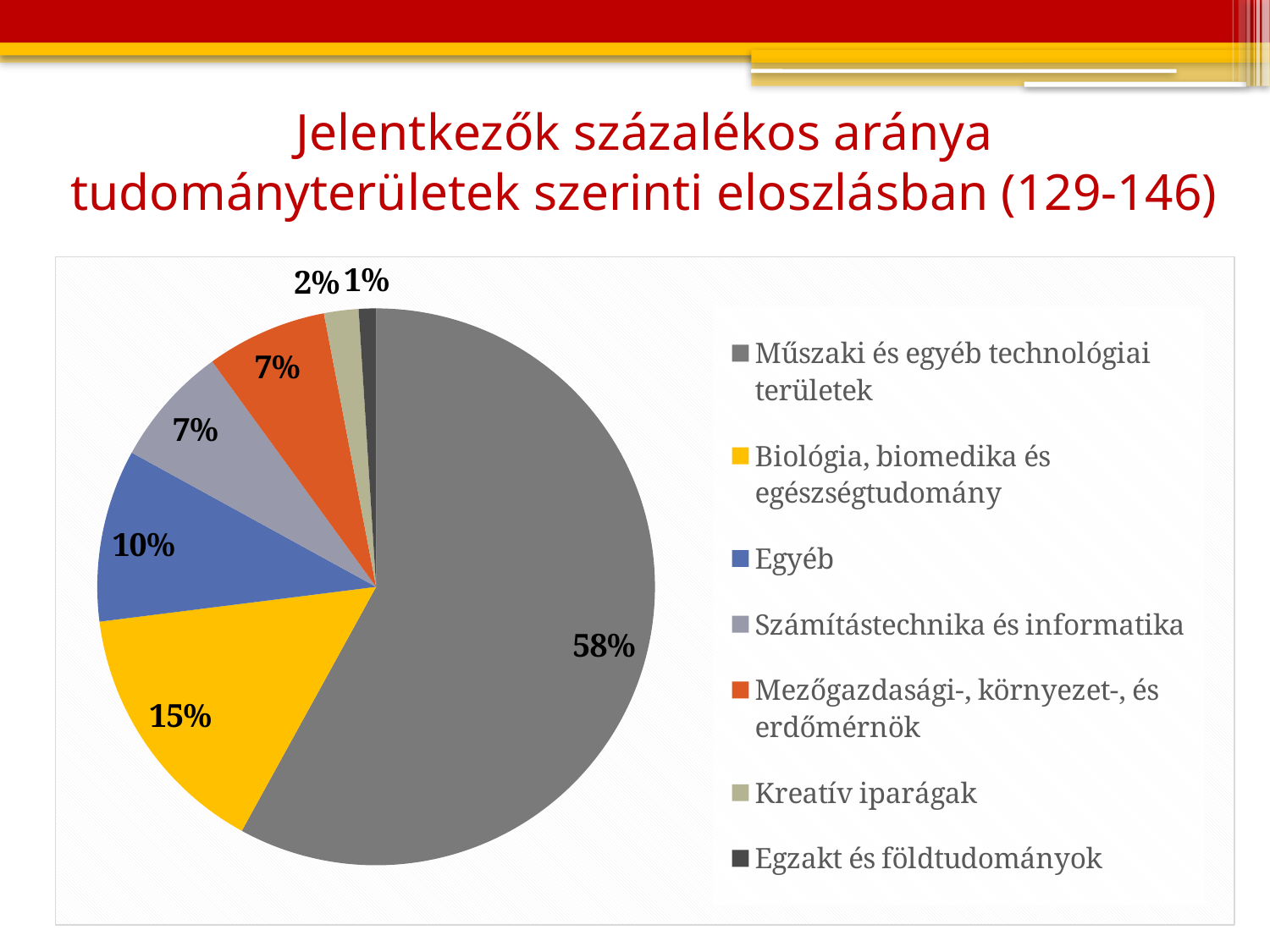
What is the value shown for 'Egyéb'? 10% What kind of chart is shown on the slide? pie chart What share of the pie does 'Műszaki és egyéb technológiai területek' have? 58% What share of the pie does 'Biológia, biomedika és egészségtudomány' have? 15% What is the value shown for 'Egzakt és földtudományok'? 1% What is the value shown for 'Kreatív iparágak'? 2% What is the difference between the shares of 'Műszaki és egyéb technológiai területek' and 'Biológia, biomedika és egészségtudomány'? 43% Which is larger, the share of 'Egyéb' or the share of 'Számítástechnika és informatika'? Egyéb Which category has the largest share of the pie? Műszaki és egyéb technológiai területek Which category has the smallest share of the pie? Egzakt és földtudományok How many categories does the legend of the pie chart list? 7 What is the title of the chart on the slide? Jelentkezők százalékos aránya tudományterületek szerinti eloszlásban (129-146)